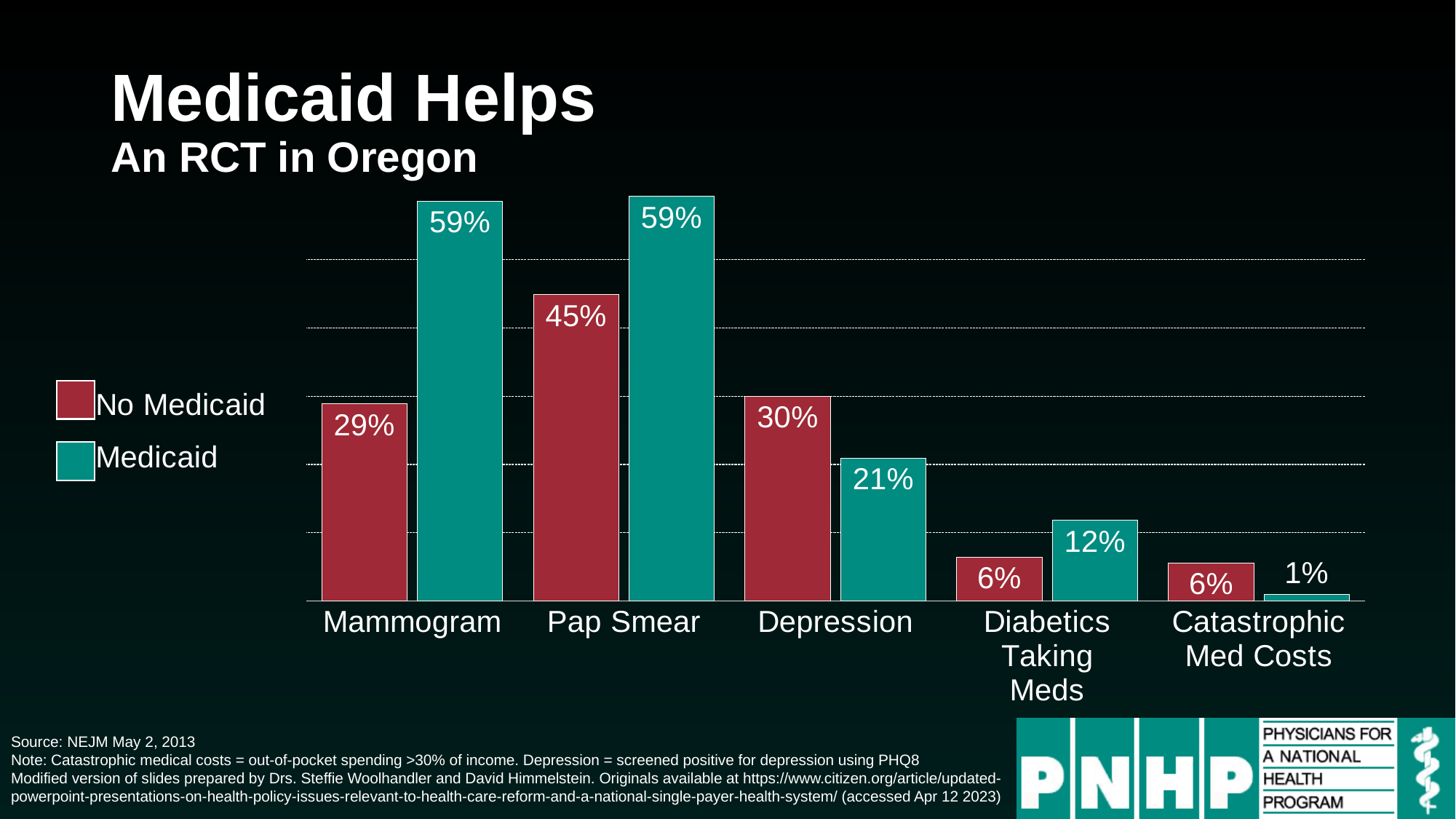
Which category has the lowest Medicaid value? Catastrophic Med Costs What is the Medicaid value for Catastrophic Med Costs? 1% What is the No Medicaid value for Pap Smear? 45% Which category has the highest No Medicaid value? Pap Smear What kind of chart is shown on the slide? Bar chart How many categories are shown on the x axis? 5 How many series does the legend list? 2 What is the No Medicaid value for Diabetics Taking Meds? 6% What is the Medicaid value for Depression? 21% For Depression, which is larger: the No Medicaid value or the Medicaid value? No Medicaid What is the Medicaid value for Mammogram? 59% What is the difference between the Medicaid and No Medicaid values for Mammogram? 30%